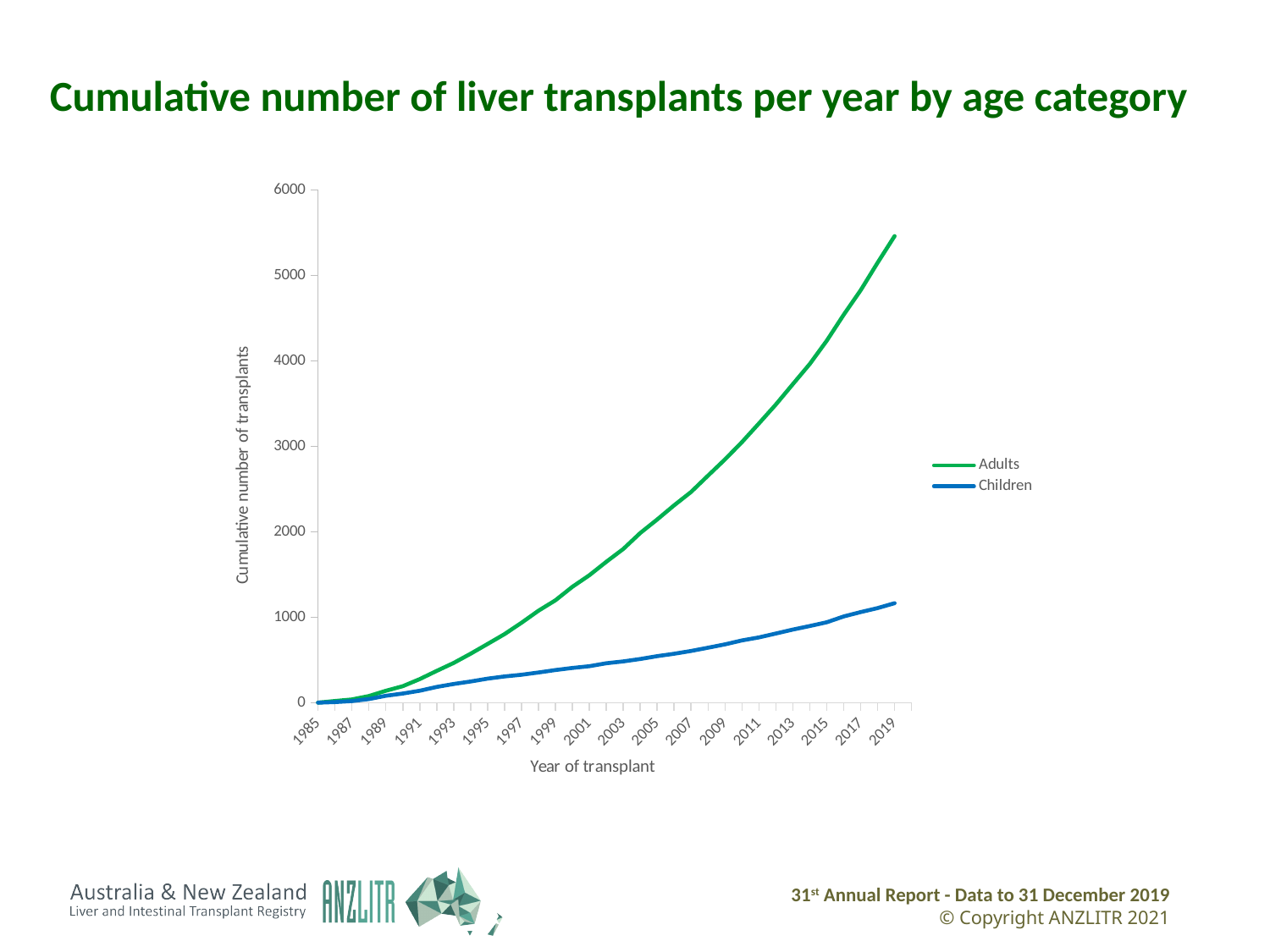
Is the value for Adults in 2019 greater or less than 5000? greater What is the label on the y axis? Cumulative number of transplants Is the value for Children in 2009 greater or less than 1000? less How many series does the legend list? 2 What kind of chart is shown on the slide? line chart Do the values for Children rise or fall from 1985 to 2019? rise Is the value for Adults in 2017 greater or less than 5000? less Which series has the higher value in 2019, Adults or Children? Adults Do the values for Adults rise or fall from 1985 to 2019? rise What is the title of the chart? Cumulative number of liver transplants per year by age category